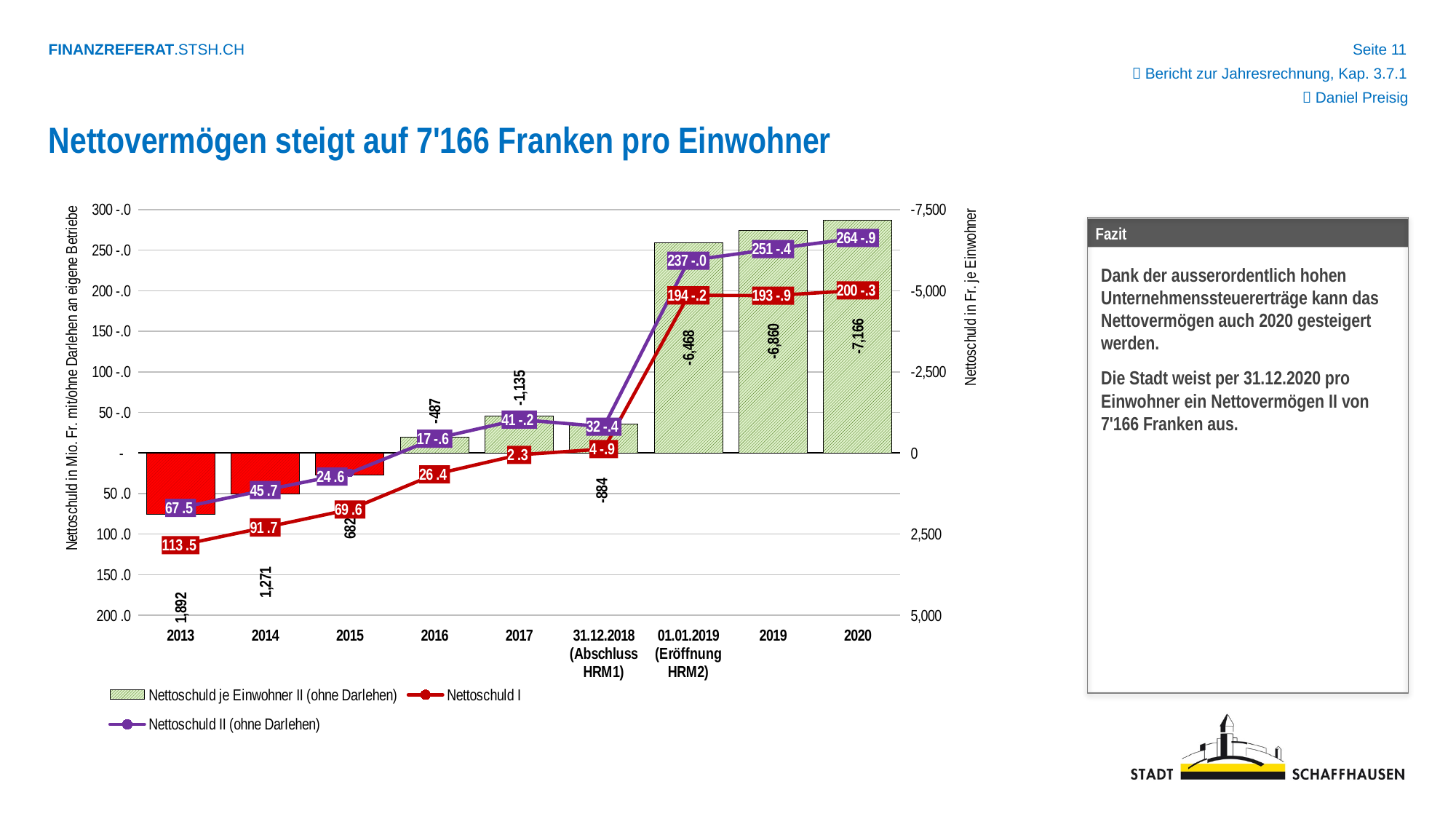
What is the title of the slide above the chart? Nettovermögen steigt auf 7'166 Franken pro Einwohner What kind of chart is shown on the slide? Combined bar and line chart Which category has the lowest value for Nettoschuld je Einwohner II (ohne Darlehen)? 2020 What is the difference between the Nettoschuld je Einwohner II (ohne Darlehen) values for 2013 and 2014? 621 Which category has the highest value for Nettoschuld je Einwohner II (ohne Darlehen)? 2013 What is the value of the Nettoschuld je Einwohner II (ohne Darlehen) bar for 2013? 1,892 In 2020, which line has the larger value: Nettoschuld I or Nettoschuld II (ohne Darlehen)? Nettoschuld I How many series does the chart legend list? 3 How many categories are shown along the x axis of the chart? 9 What is the value of the Nettoschuld je Einwohner II (ohne Darlehen) bar for 2017? -1,135 What is the value of the Nettoschuld je Einwohner II (ohne Darlehen) bar for 2020? -7,166 What is the value of the Nettoschuld je Einwohner II (ohne Darlehen) bar for 01.01.2019 (Eröffnung HRM2)? -6,468